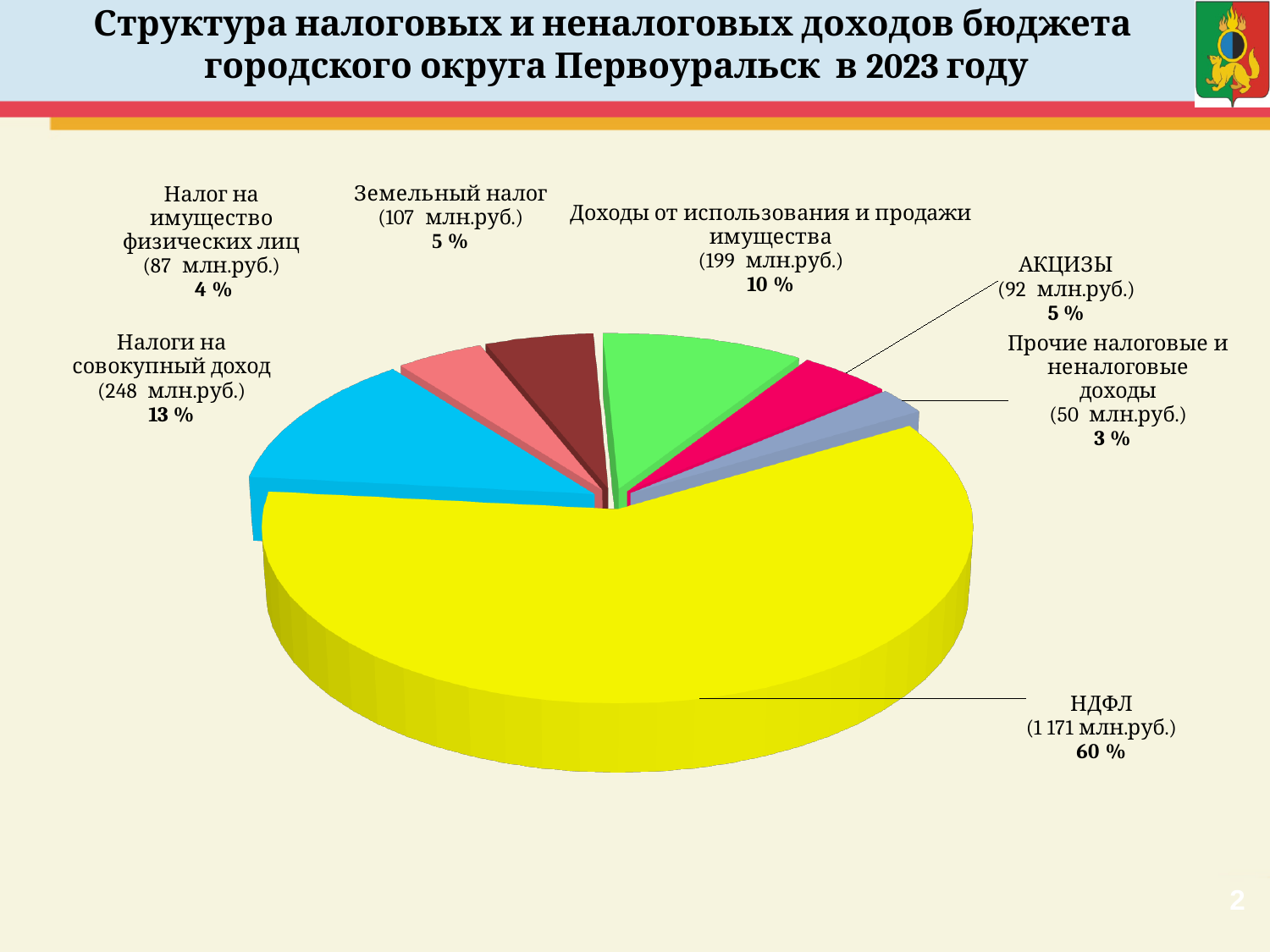
What percentage is shown for Доходы от использования и продажи имущества? 10 % What colour is the НДФЛ slice? yellow What is the difference in млн.руб. between Земельный налог and АКЦИЗЫ? 15 млн.руб. What type of chart is shown on the slide? pie chart Which is larger: Налог на имущество физических лиц or Налоги на совокупный доход? Налоги на совокупный доход Which category has the largest slice of the pie? НДФЛ What share of the pie does НДФЛ represent? 60 % How many slices does the pie chart have? 7 Which category has the smallest slice of the pie? Прочие налоговые и неналоговые доходы What is the value shown for Налоги на совокупный доход? 248 млн.руб. What is the value shown for НДФЛ? 1 171 млн.руб. What is the value shown for Прочие налоговые и неналоговые доходы? 50 млн.руб.